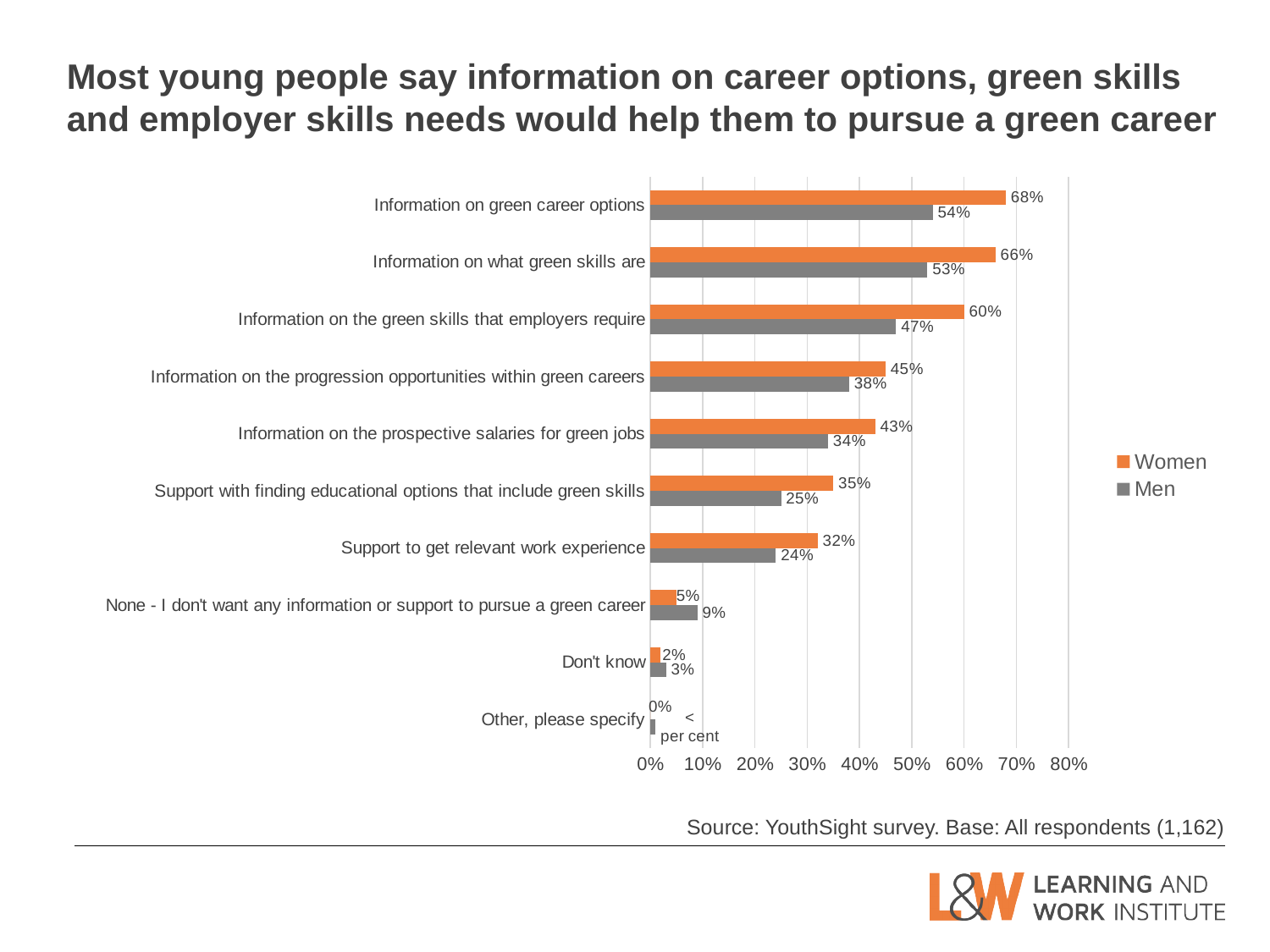
For 'None - I don't want any information or support to pursue a green career', which group has the larger value, women or men? Men What is the value for men for 'Support to get relevant work experience'? 24% How many series does the legend list? 2 Is the value for men for 'Information on the progression opportunities within green careers' greater or less than 40%? less How many categories are shown on the chart? 10 Which category has the lowest value for men? Other, please specify What is the difference between women and men for 'Information on the green skills that employers require'? 13 percentage points Which colour represents women in the chart? Orange What percentage of women said information on green career options would help them pursue a green career? 68% What percentage of men said information on what green skills are would help them? 53% What type of chart is shown on the slide? Bar chart Which category has the highest value for women? Information on green career options